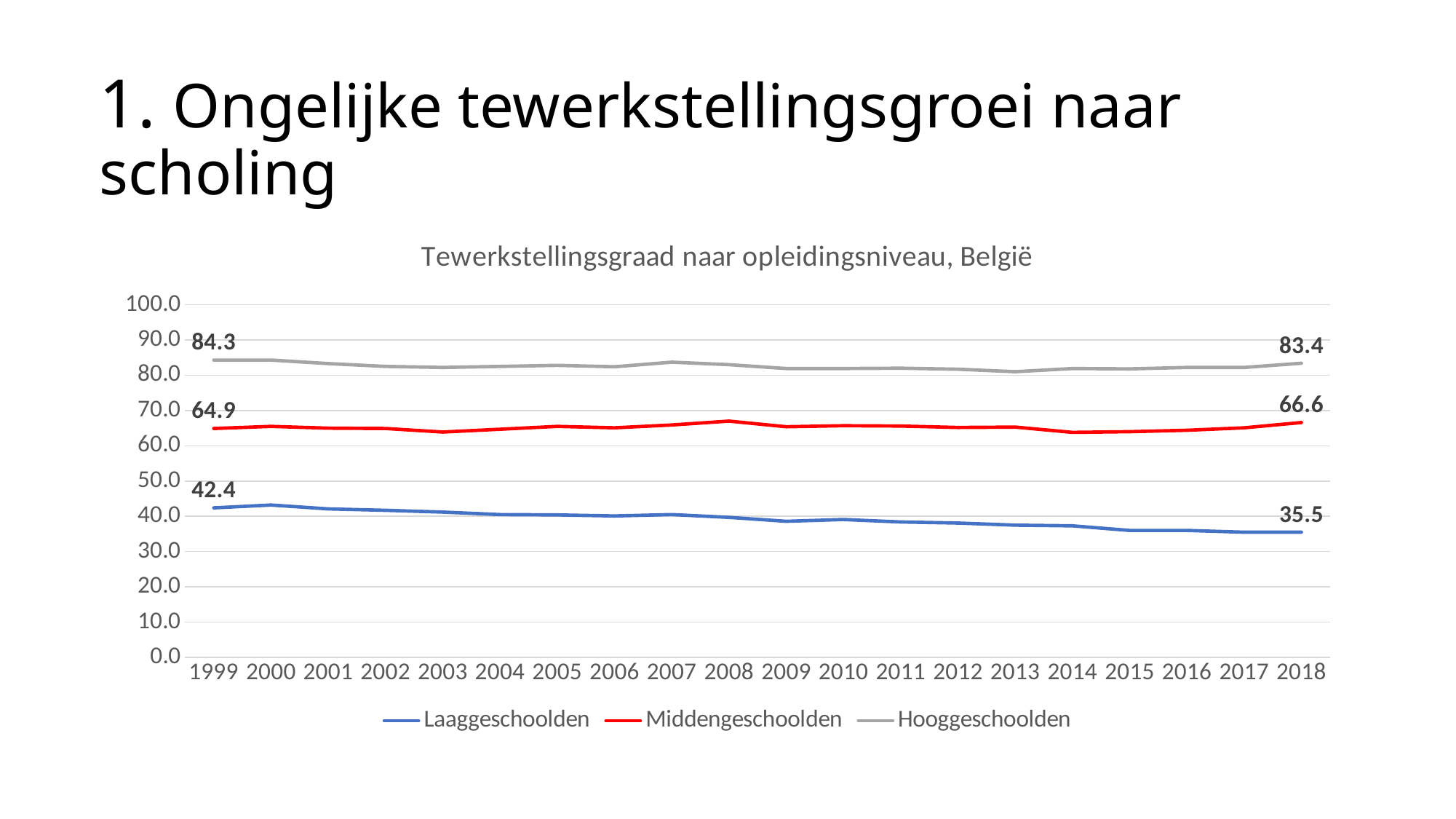
What is the difference between the Laaggeschoolden values in 1999 and 2018? 6.9 What is the value for Middengeschoolden in 2018? 66.6 Does the Laaggeschoolden line rise or fall from 1999 to 2018? fall What is the value for Laaggeschoolden in 2018? 35.5 Which is larger: the Middengeschoolden value in 2018 or in 1999? 2018 Which series has the lowest value in 1999? Laaggeschoolden What is the value for Hooggeschoolden in 1999? 84.3 What is the value for Middengeschoolden in 1999? 64.9 How many series does the legend list? 3 Which series has the highest value in 2018? Hooggeschoolden What kind of chart is shown? line chart